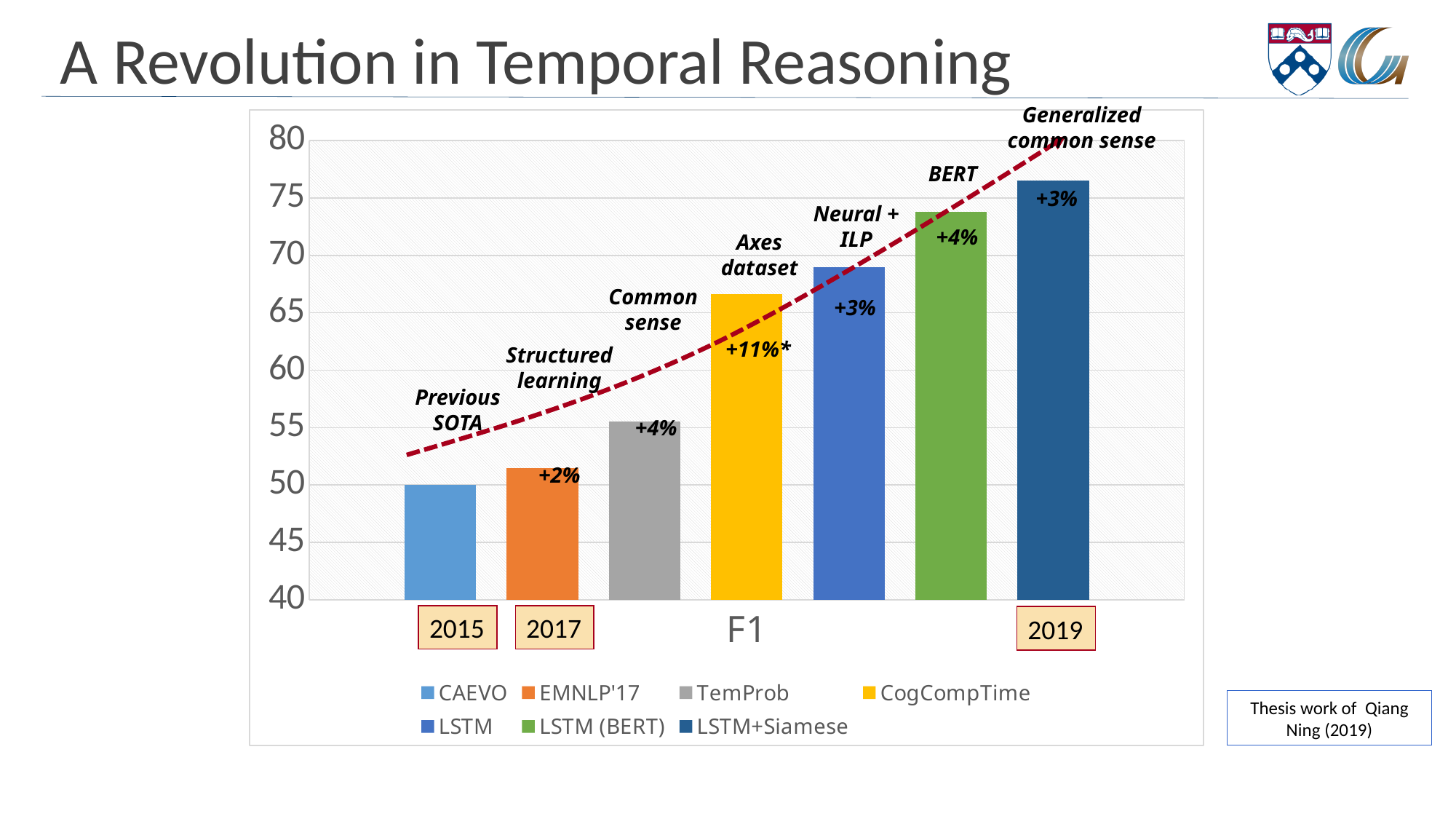
How many series does the legend list? 7 Is the F1 value for TemProb greater or less than 60? less What improvement label is printed on the CogCompTime bar? +11%* Which bar is taller, LSTM (BERT) or LSTM? LSTM (BERT) Which series has the lowest F1 bar? CAEVO Is the F1 value for CogCompTime greater or less than 65? greater What kind of chart is shown on the slide? bar chart What is the F1 value of the CAEVO bar? 50 Which series has the highest F1 bar? LSTM+Siamese Is the F1 value for LSTM+Siamese greater or less than 75? greater What is the title of the slide containing the chart? A Revolution in Temporal Reasoning What improvement label is printed on the EMNLP'17 bar? +2%